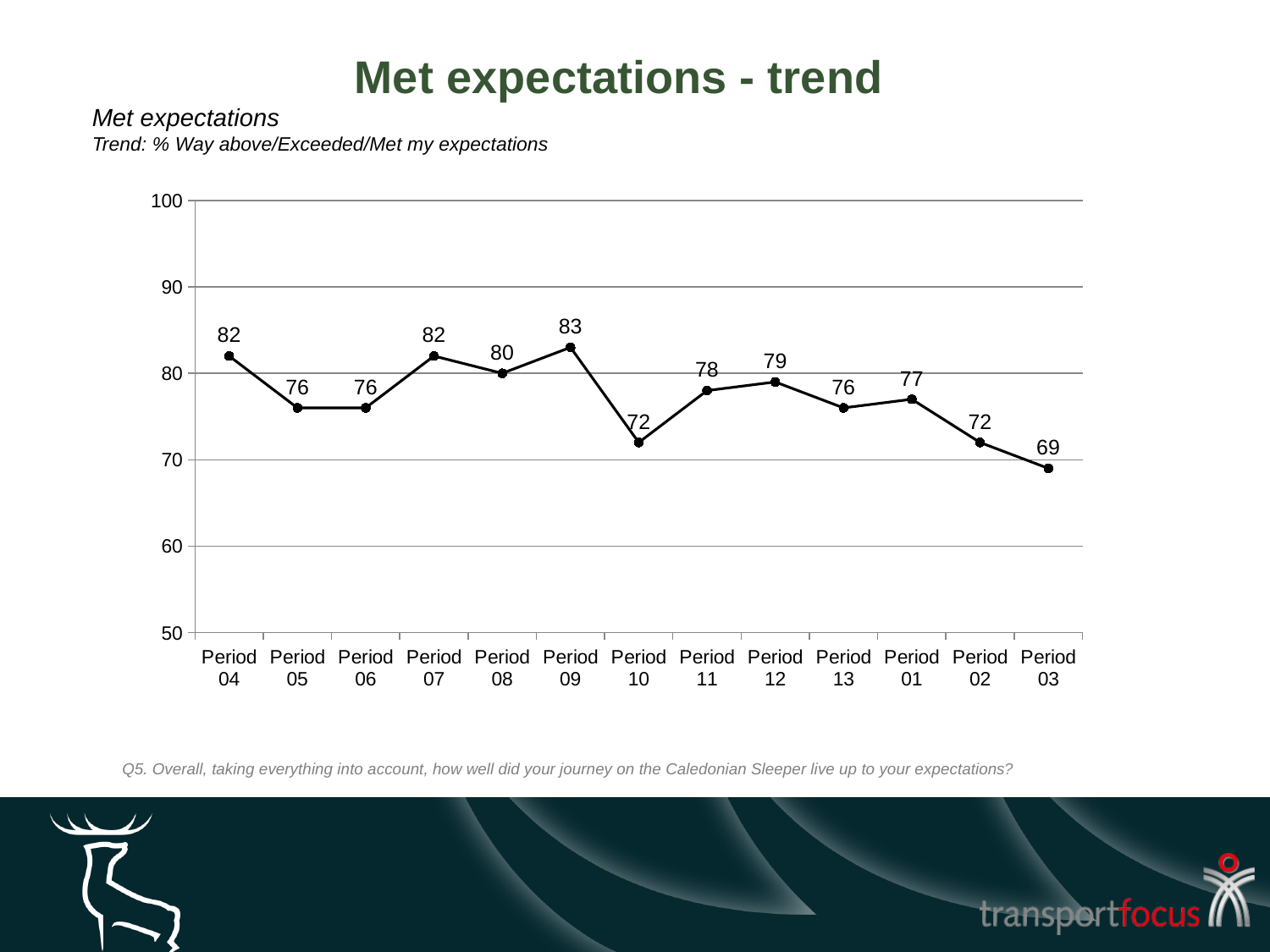
What is the value for Period 09? 83 How many periods are plotted on the chart? 13 Which period has the lowest value? Period 03 What is the title of the chart? Met expectations What is the value for Period 10? 72 Do the values rise or fall from Period 01 to Period 03? Fall What is the value for Period 03? 69 Which is larger, the value for Period 12 or the value for Period 13? Period 12 What is the difference between the values for Period 09 and Period 10? 11 Is the value for Period 01 greater or less than 70? greater What kind of chart is shown on the slide? Line chart Which period has the highest value? Period 09